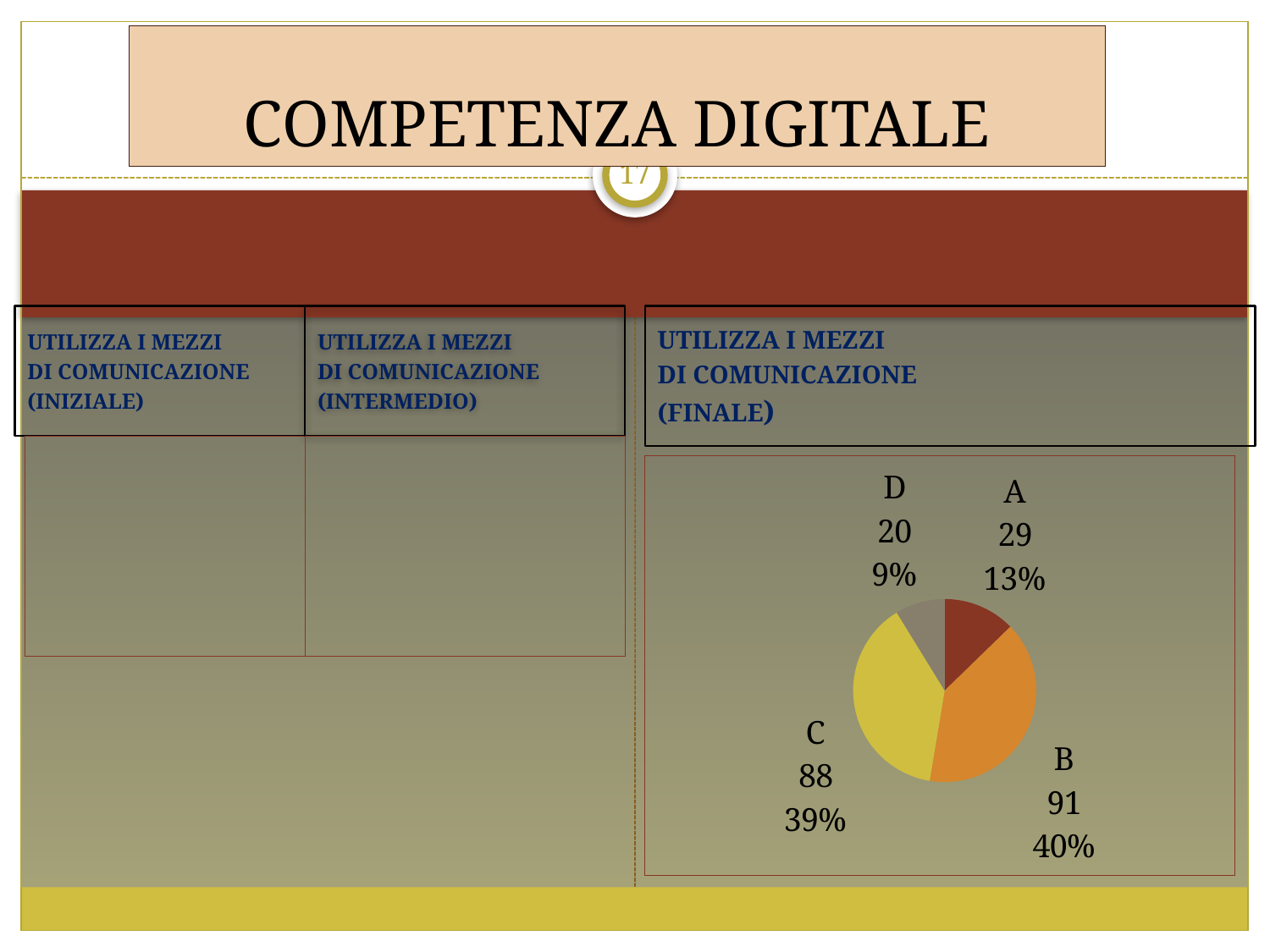
What is the difference between the values for B and C in the pie chart? 3 What is the value for category D in the pie chart? 20 Which category has the largest slice in the pie chart? B Which is larger in the pie chart, the value for A or the value for D? A What is the total of all the values shown in the pie chart? 228 What is the value for category B in the pie chart? 91 What percentage share does category C have in the pie chart? 39% Which panel of the slide contains the pie chart? UTILIZZA I MEZZI DI COMUNICAZIONE (FINALE) How many slices does the pie chart have? 4 Which category has the smallest slice in the pie chart? D What percentage share does category A have in the pie chart? 13% What kind of chart is shown on the slide? pie chart